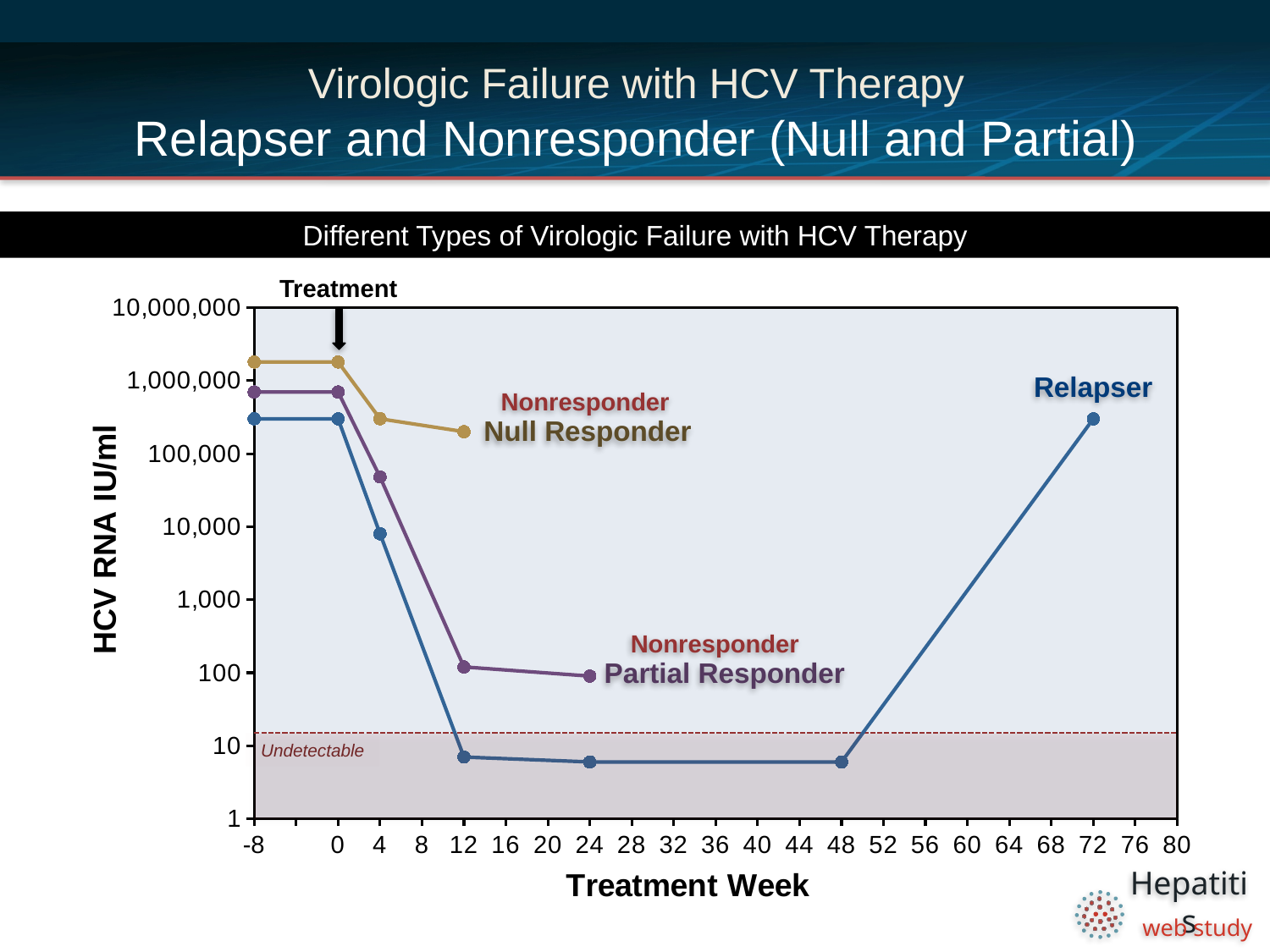
What is the title of the chart? Different Types of Virologic Failure with HCV Therapy How many data points are plotted for the Relapser series? 7 What is the label of the y axis? HCV RNA IU/ml At treatment week 0, which series has the highest HCV RNA level? Null Responder Is the Relapser value at treatment week 24 greater or less than 10? less Is the Partial Responder value at treatment week 24 greater or less than 1,000? less How many series (patient response types) are plotted on the chart? 3 Is the Relapser value at treatment week 72 greater or less than 100,000? greater At treatment week 0, which series has the lowest HCV RNA level? Relapser What kind of chart is shown on the slide? line chart